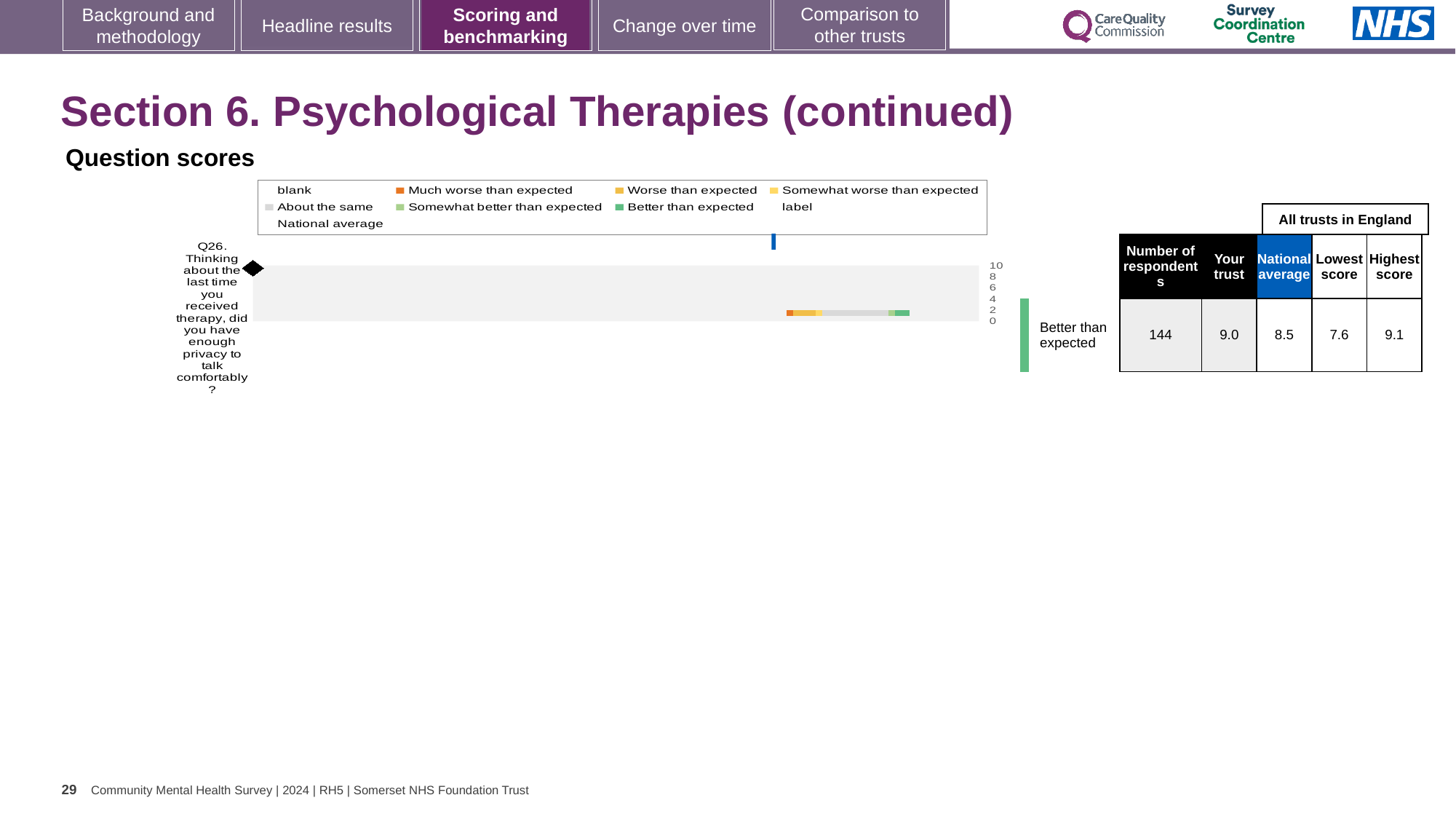
What is the highest value shown on the chart's axis? 10 What is the difference between the 'Your trust' score and the national average for Q26? 0.5 In the table next to the chart, what is the national average score for Q26? 8.5 In the table next to the chart, what is the 'Your trust' score for Q26? 9.0 In the table next to the chart, what is the highest score among all trusts in England for Q26? 9.1 In the table next to the chart, what is the lowest score among all trusts in England for Q26? 7.6 What kind of chart is shown under 'Question scores'? bar chart How many questions (categories) are plotted in the chart? 1 Which is larger for Q26, the 'Your trust' score or the national average? Your trust In the table next to the chart, how many respondents answered Q26? 144 Which question is plotted in the chart? Q26. Thinking about the last time you received therapy, did you have enough privacy to talk comfortably? According to the label beside the chart, how is the trust's result for Q26 categorised? Better than expected